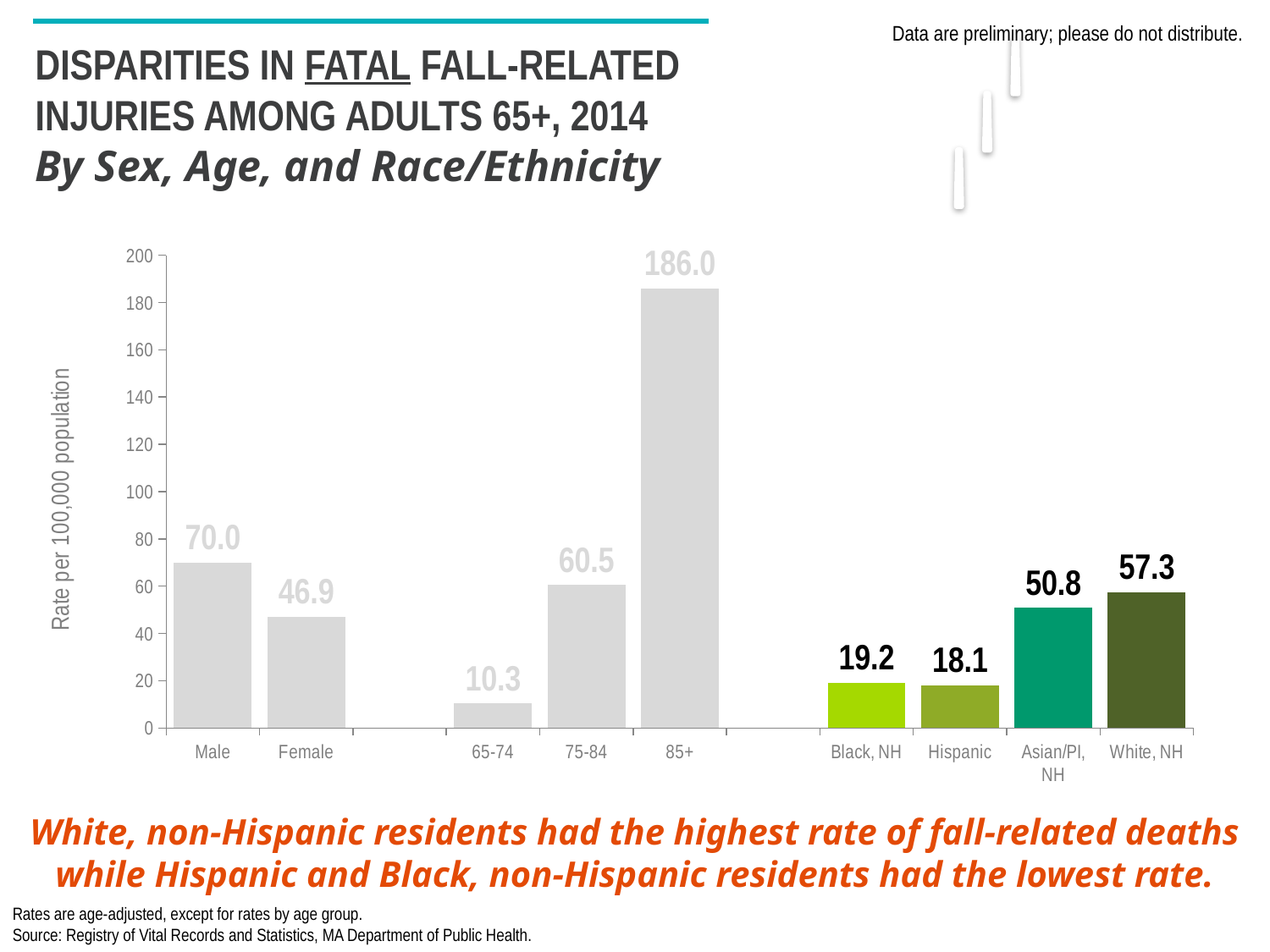
Is the rate for the 85+ age group greater or less than 180? greater How many categories are plotted on the chart? 9 What is the rate for the 85+ age group? 186.0 Which category has the lowest rate on the chart? 65-74 What is the rate for Asian/PI, NH residents? 50.8 Which has a higher rate, the 75-84 age group or White, NH residents? 75-84 What is the difference between the Male and Female rates? 23.1 What is the rate for Hispanic residents? 18.1 What kind of chart is shown on the slide? Bar chart What is the fatal fall-related injury rate for Male adults 65+? 70.0 Which category has the highest rate on the chart? 85+ What is the difference between the White, NH and Black, NH rates? 38.1